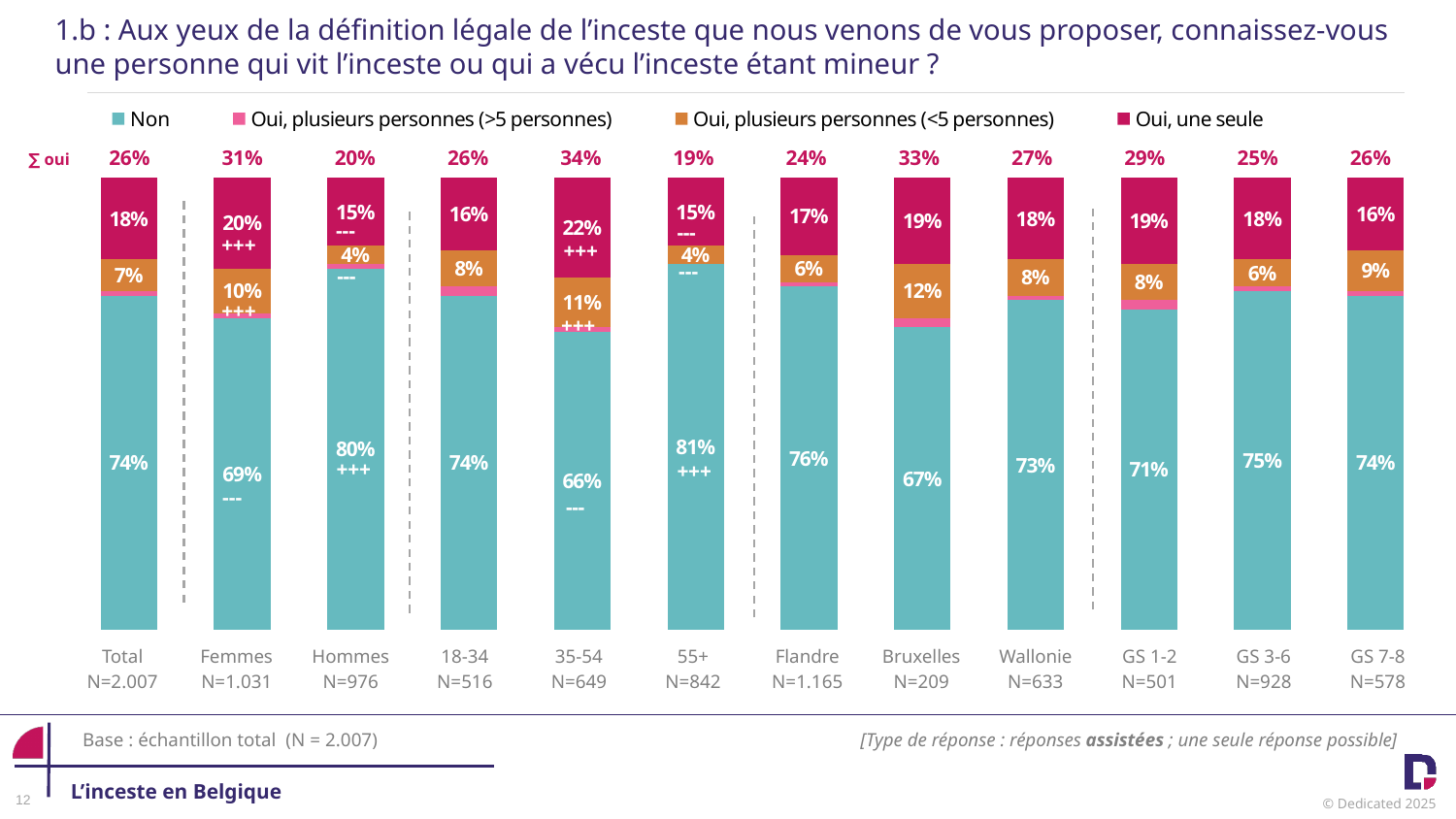
What is the value of 'Oui, plusieurs personnes (<5 personnes)' for Bruxelles? 12% Which category has the lowest 'Non' value? 35-54 What is the difference between the 'Non' values for Hommes and Femmes? 11% Which series is shown in the teal colour at the bottom of each bar? Non How many categories (bars) are plotted along the x axis? 12 Which category has the highest 'Non' value? 55+ What is the '∑ oui' value shown above the Femmes bar? 31% How many series does the legend list? 4 Which is larger, the 'Oui, une seule' value for Femmes or for Hommes? Femmes What is the value of 'Oui, une seule' for the 35-54 category? 22% What kind of chart is shown on the slide? Stacked bar chart What is the value of 'Non' for the Total category? 74%